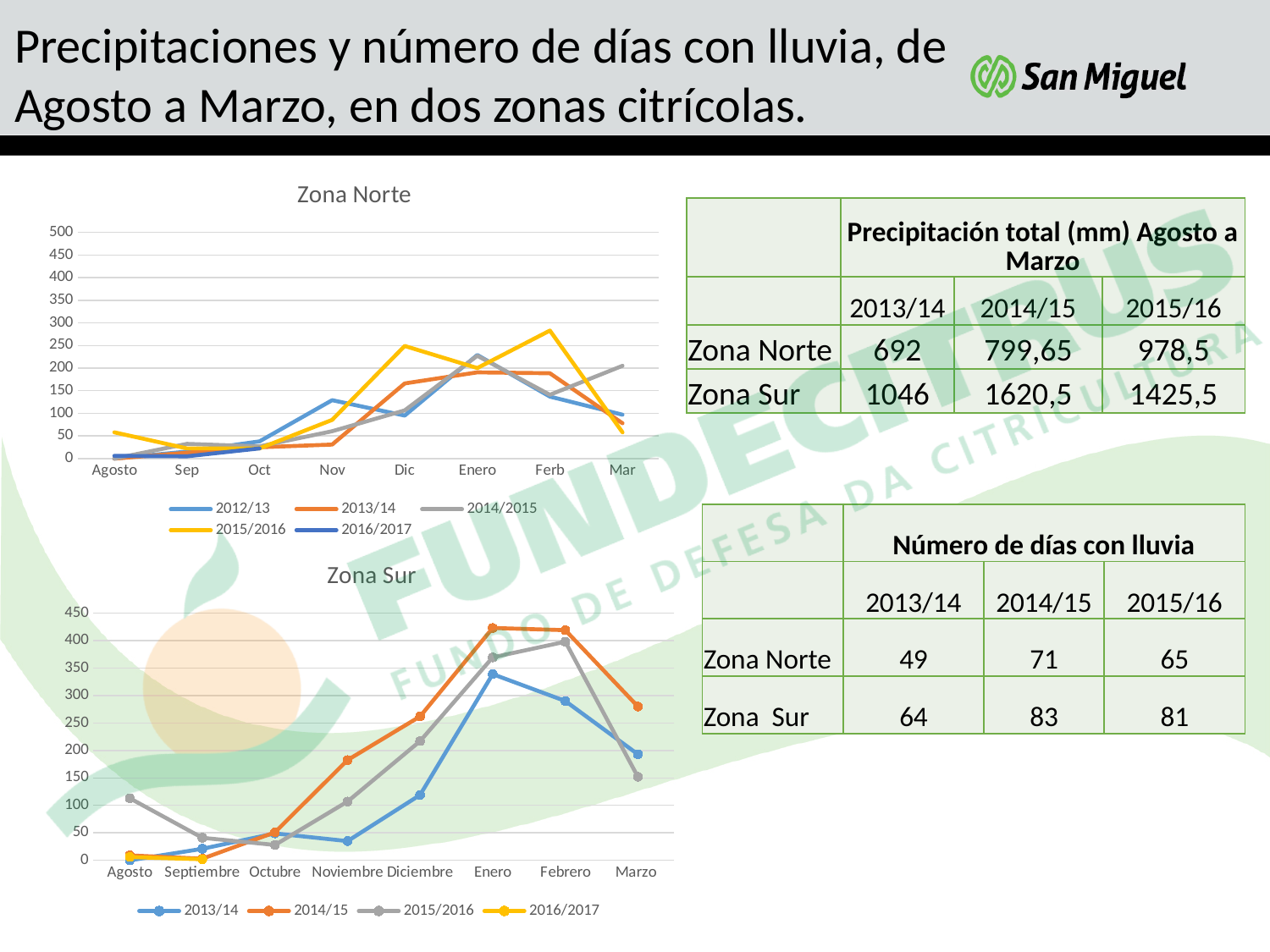
In the Zona Sur chart, does the 2013/14 series rise or fall from Enero to Marzo? fall In the Zona Norte chart, is the value for 2015/2016 in Ferb greater or less than 250? greater In the Zona Sur chart, is the value for 2014/15 in Enero greater or less than 400? greater In the Zona Sur chart, which series has the larger value in Enero, 2014/15 or 2013/14? 2014/15 How many series does the legend of the Zona Sur chart list? 4 In the Zona Sur chart, is the value for 2013/14 in Enero greater or less than 300? greater In the Zona Sur chart, which month has the highest value for the 2013/14 series? Enero How many months are shown on the x axis of the Zona Sur chart? 8 What kind of chart is the Zona Norte chart? line chart In the Zona Norte chart, which month has the highest value for the 2015/2016 series? Ferb How many series does the legend of the Zona Norte chart list? 5